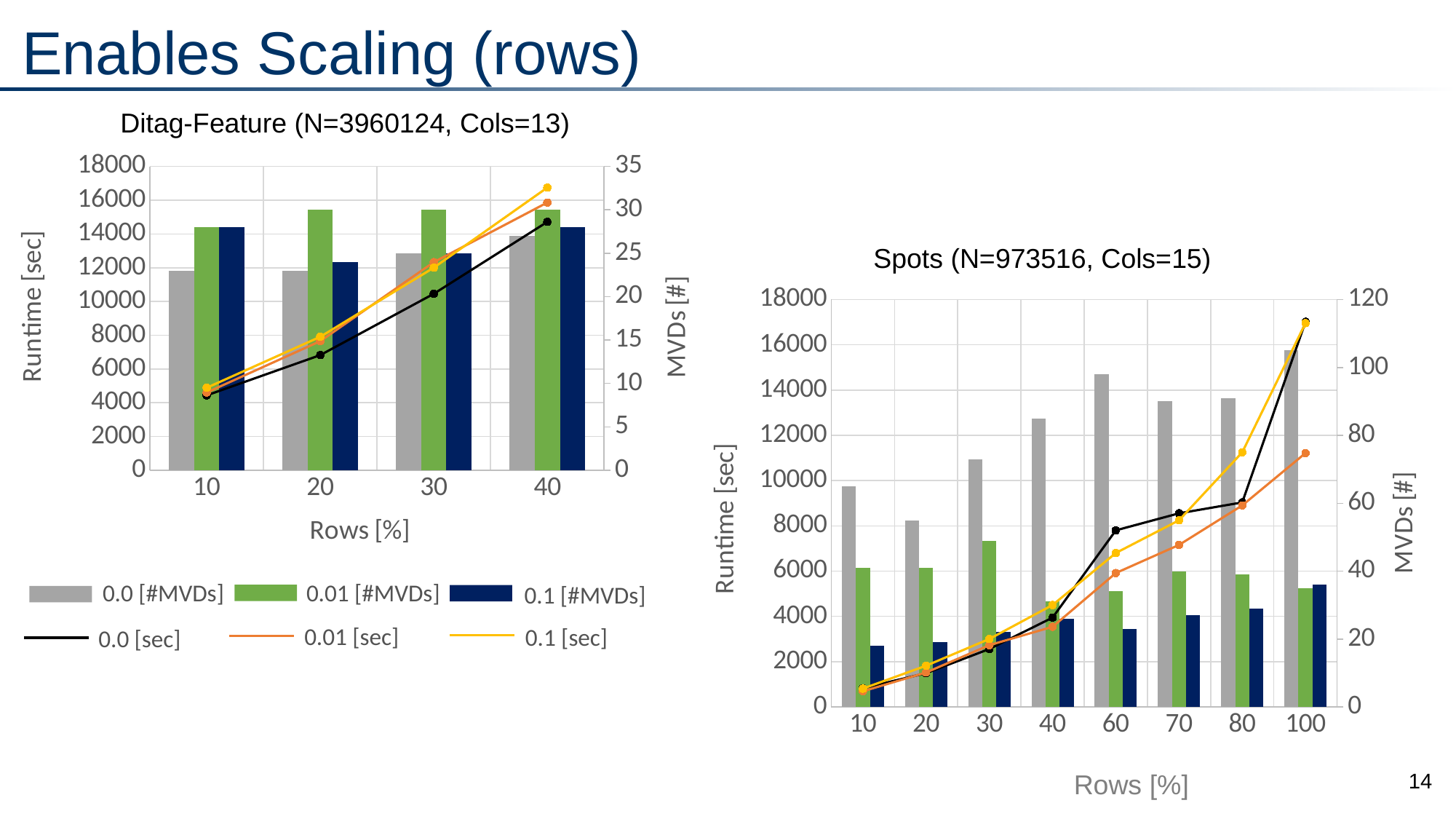
In the Spots chart, at which Rows [%] value is the 0.0 [#MVDs] bar lowest? 20 How many row-percentage categories are shown on the x axis of the Ditag-Feature chart? 4 In the Ditag-Feature chart, at which Rows [%] value is the 0.0 [#MVDs] bar highest? 40 What kind of chart is the Ditag-Feature chart? Combined bar and line chart How many row-percentage categories are shown on the x axis of the Spots chart? 8 In the Ditag-Feature chart, do the [sec] lines rise or fall as Rows [%] increases? Rise In the Spots chart, at which Rows [%] value is the 0.01 [#MVDs] bar highest? 30 In the Spots chart, is the 0.0 [#MVDs] bar taller at 60 or at 70 rows? 60 In the Spots chart, at which Rows [%] value is the 0.0 [#MVDs] bar highest? 100 In the Spots chart, is the 0.0 [#MVDs] bar at 60 rows above or below the 14000 gridline? Above How many series does the legend list for the charts? 6 What is the title of the chart on the right side of the slide? Spots (N=973516, Cols=15)